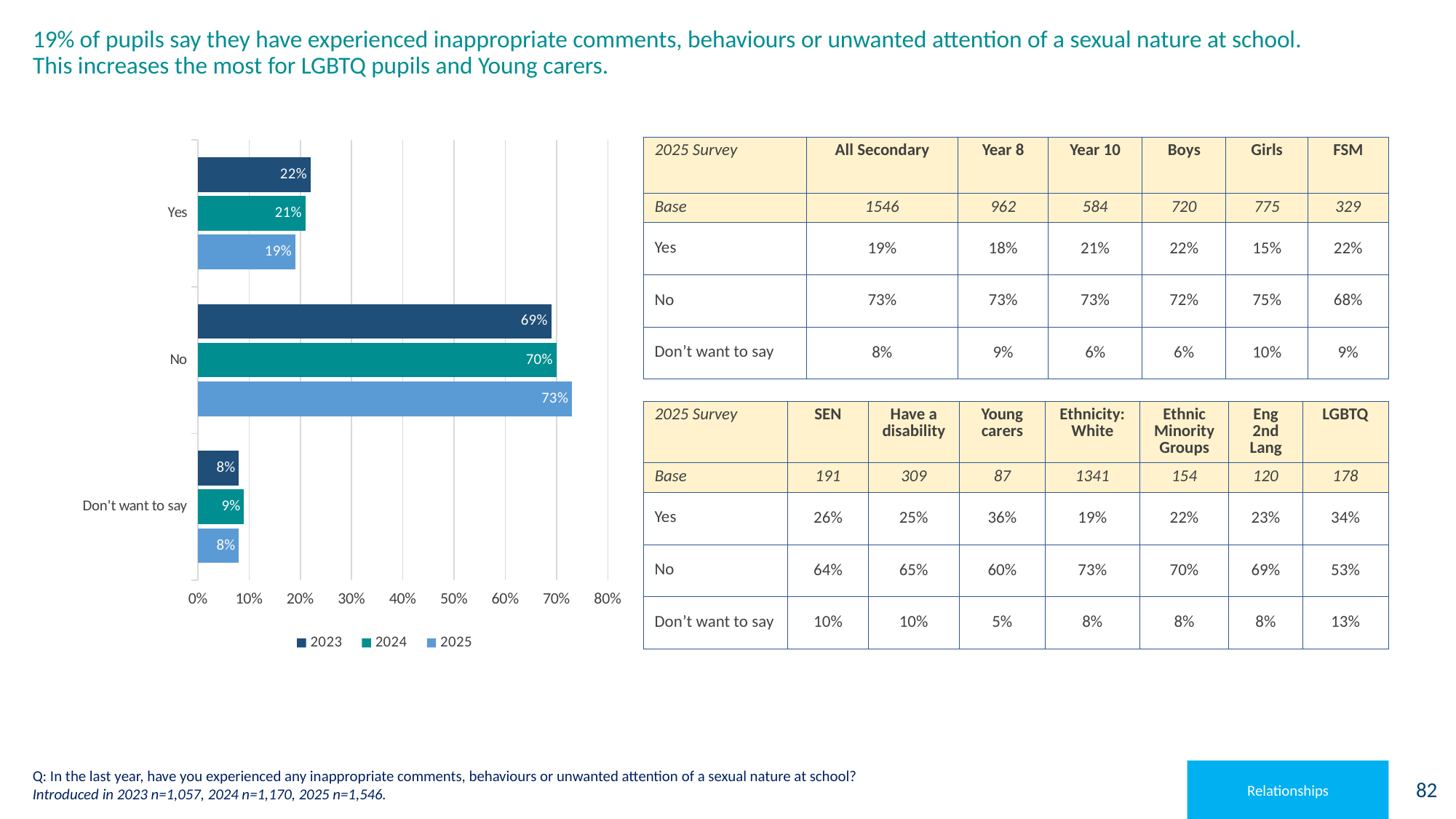
How many series does the legend list? 3 Which years are listed in the chart legend? 2023, 2024, 2025 What is the value for 'Yes' in the 2025 series? 19% Which category has the lowest value in the 2023 series? Don't want to say Is the value for 'No' in 2024 greater or less than 60%? greater What kind of chart is shown on the slide? Bar chart Which category has the highest value in the 2025 series? No What is the value for 'Don't want to say' in the 2024 series? 9% What is the difference between the 2025 and 2023 values for 'No'? 4 percentage points Which is larger for 'Yes': the 2023 value or the 2025 value? 2023 What is the value for 'No' in the 2023 series? 69% How many categories are shown on the chart? 3